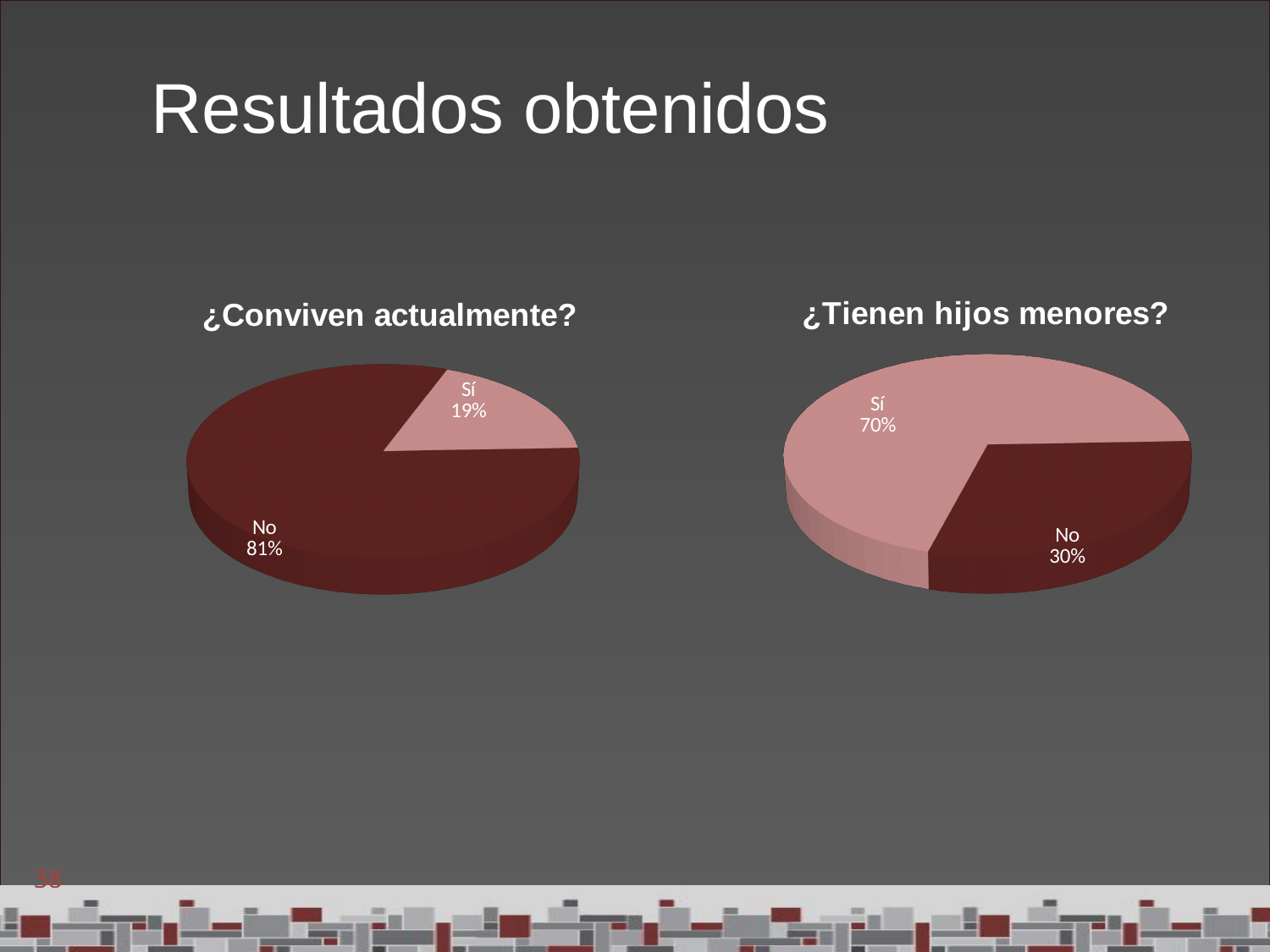
In the '¿Conviven actualmente?' chart, which answer has the largest share? No In the '¿Tienen hijos menores?' chart, what percentage answered 'No'? 30% In the '¿Tienen hijos menores?' chart, which is larger, 'Sí' or 'No'? Sí In the '¿Tienen hijos menores?' chart, what is the difference in percentage points between 'Sí' and 'No'? 40 In the '¿Tienen hijos menores?' chart, which answer has the smallest share? No In the '¿Tienen hijos menores?' chart, what percentage answered 'Sí'? 70% In the '¿Conviven actualmente?' chart, what percentage answered 'No'? 81% In the '¿Conviven actualmente?' chart, what percentage answered 'Sí'? 19% How many slices does the '¿Tienen hijos menores?' chart have? 2 How many charts are shown on the slide? 2 What type of chart is used for '¿Conviven actualmente?'? Pie chart In the '¿Conviven actualmente?' chart, what is the difference in percentage points between 'No' and 'Sí'? 62